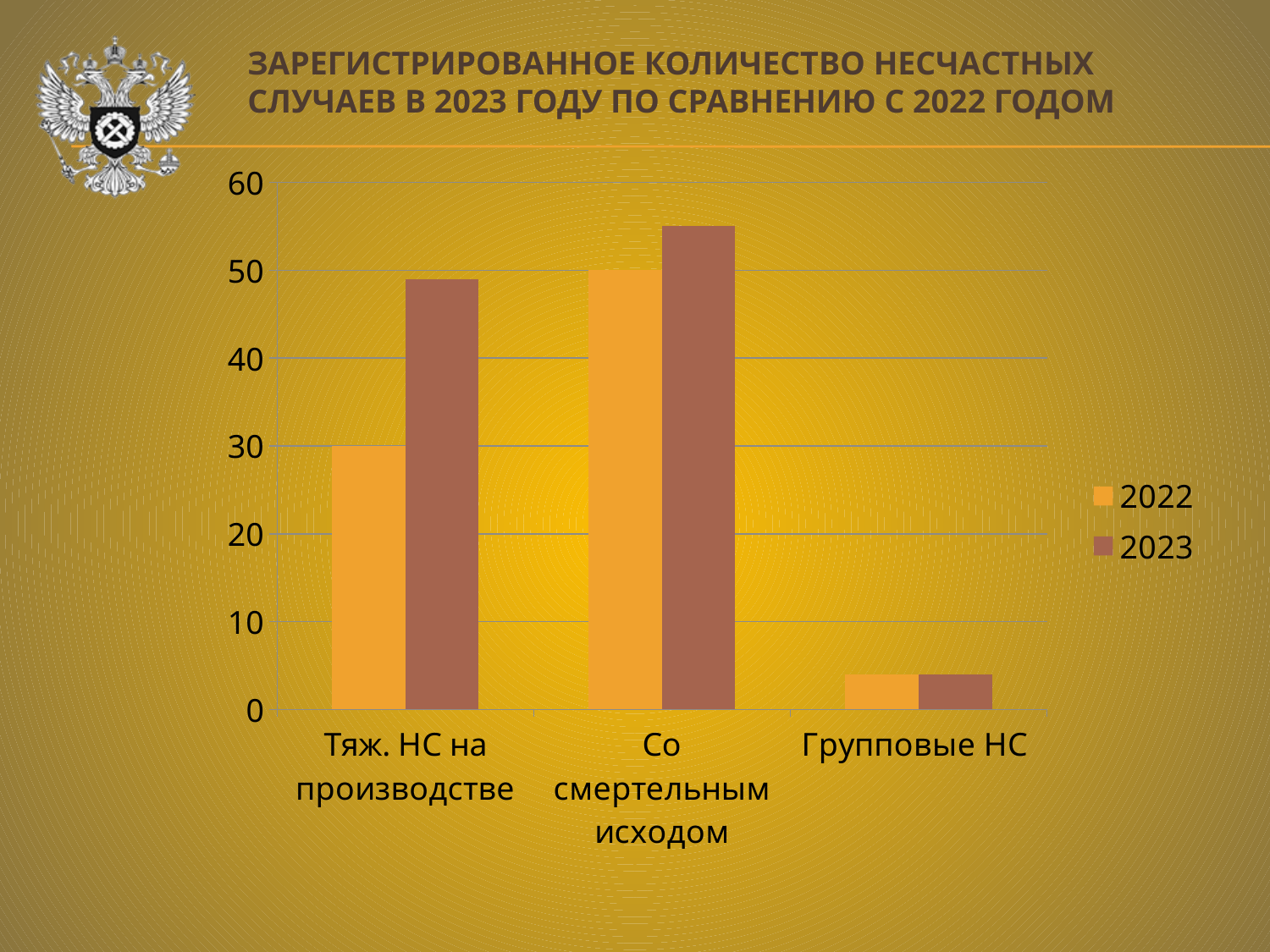
What kind of chart is shown on the slide? Bar chart For Со смертельным исходом, which year has the larger value, 2022 or 2023? 2023 Is the 2023 value for Со смертельным исходом greater or less than 50? greater For Тяж. НС на производстве, which year has the larger value, 2022 or 2023? 2023 Is the 2022 value for Групповые НС greater or less than 10? less How many categories are shown on the x axis of the chart? 3 What are the two series listed in the legend? 2022 and 2023 Is the 2023 value for Тяж. НС на производстве greater or less than 40? greater Which category has the tallest bar in the chart? Со смертельным исходом Which category has the lowest values for both years? Групповые НС Which series is shown in orange in the chart? 2022 How many series does the legend list? 2